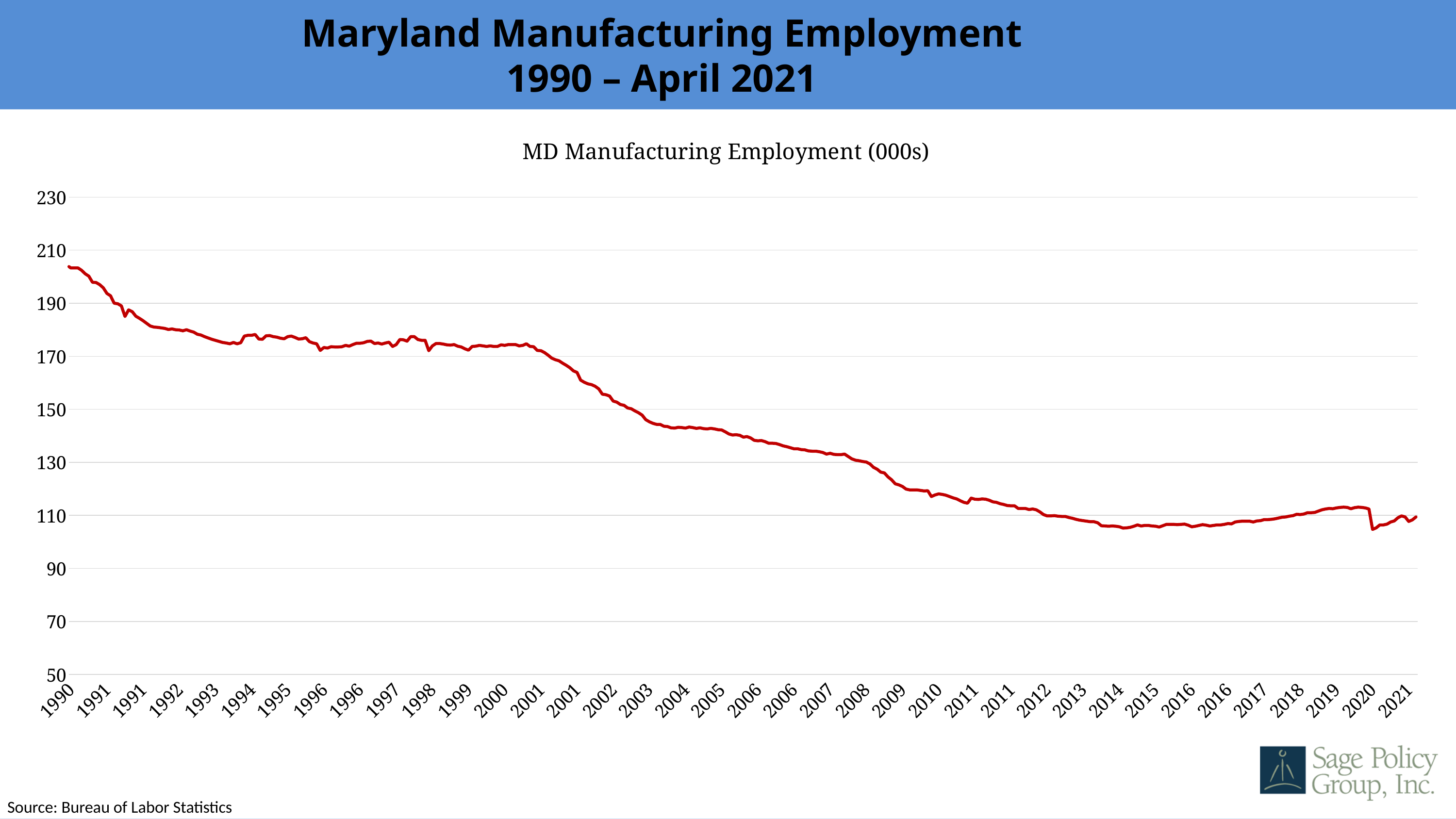
Which is larger, the value in 2000 or the value in 2010? 2000 What source is cited for the chart data? Bureau of Labor Statistics Is the value at the start of 1990 greater or less than 190? greater Overall, does Maryland manufacturing employment rise or fall from 1990 to 2021? Fall In which year does the line reach its highest value? 1990 What kind of chart is shown on the slide? Line chart Which is larger, the value in 1990 or the value in 2021? 1990 Is the value in 2014 greater or less than 110? less Is the value in 2005 greater or less than 150? less What is the title printed above the chart's plot area? MD Manufacturing Employment (000s)